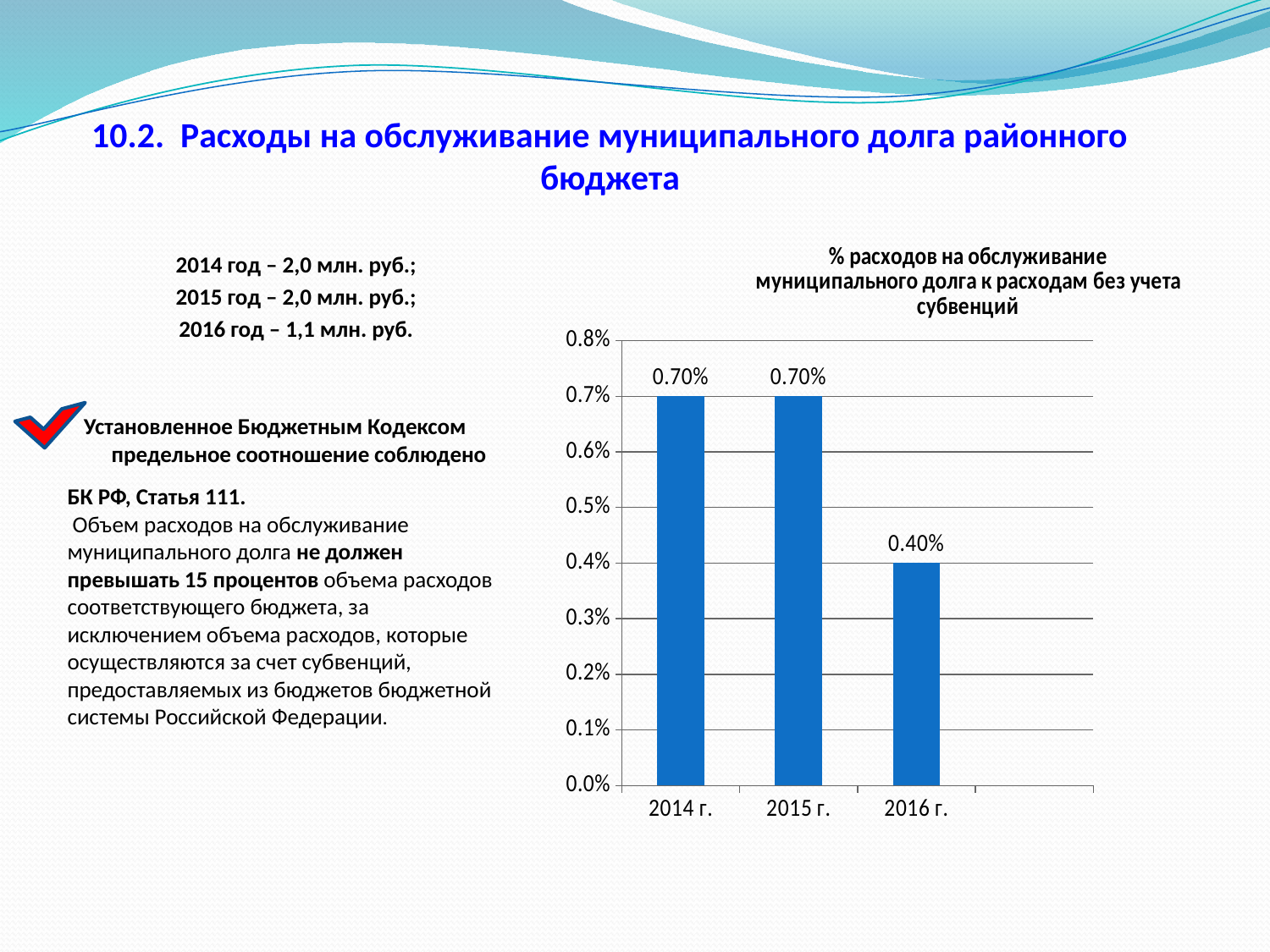
What is the value for 2015 г.? 0.70% What is the value for 2014 г.? 0.70% Which is larger, the value for 2014 г. or the value for 2016 г.? 2014 г. Is the value for 2014 г. greater or less than 0.6%? greater What kind of chart is shown on the slide? bar chart Is the value for 2016 г. greater or less than 0.5%? less What is the title of the chart? % расходов на обслуживание муниципального долга к расходам без учета субвенций How many years are shown on the chart? 3 Do the values rise or fall from 2015 г. to 2016 г.? fall Which year has the lowest value? 2016 г. What is the value for 2016 г.? 0.40% What is the difference between the values for 2015 г. and 2016 г.? 0.30%